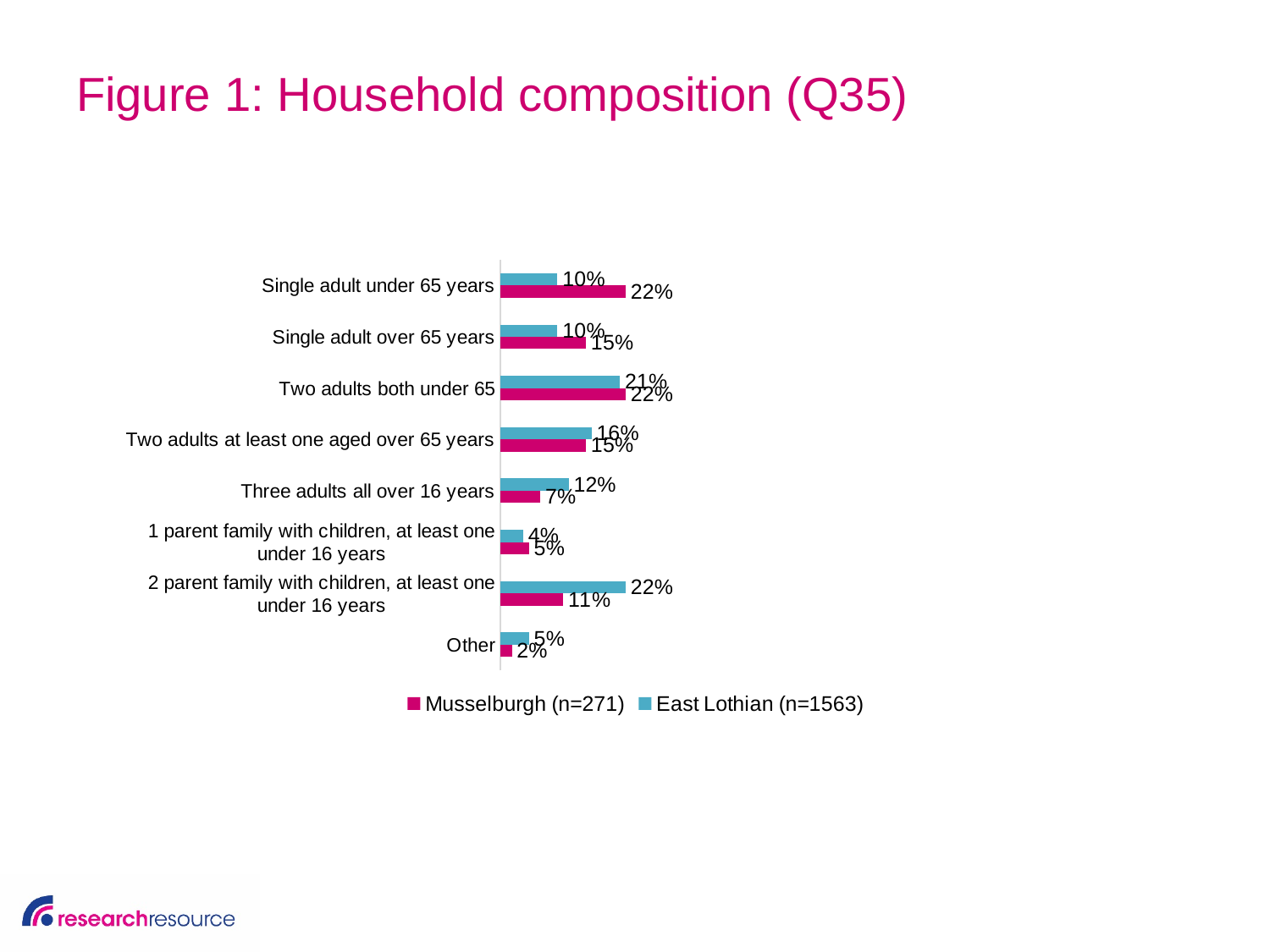
How many household composition categories are shown in the chart? 8 What is the East Lothian (n=1563) value for 2 parent family with children, at least one under 16 years? 22% Which category has the lowest East Lothian (n=1563) value? 1 parent family with children, at least one under 16 years Which category has the lowest Musselburgh (n=271) value? Other What is the East Lothian (n=1563) value for Three adults all over 16 years? 12% What is the Musselburgh (n=271) value for Other? 2% What kind of chart is shown on the slide? Bar chart How many series does the legend list? 2 What is the Musselburgh (n=271) value for Single adult under 65 years? 22% What is the difference between the Musselburgh (n=271) and East Lothian (n=1563) values for Single adult under 65 years? 12 percentage points What is the difference between the East Lothian (n=1563) and Musselburgh (n=271) values for 2 parent family with children, at least one under 16 years? 11 percentage points For Three adults all over 16 years, which is larger: the Musselburgh (n=271) value or the East Lothian (n=1563) value? East Lothian (n=1563)